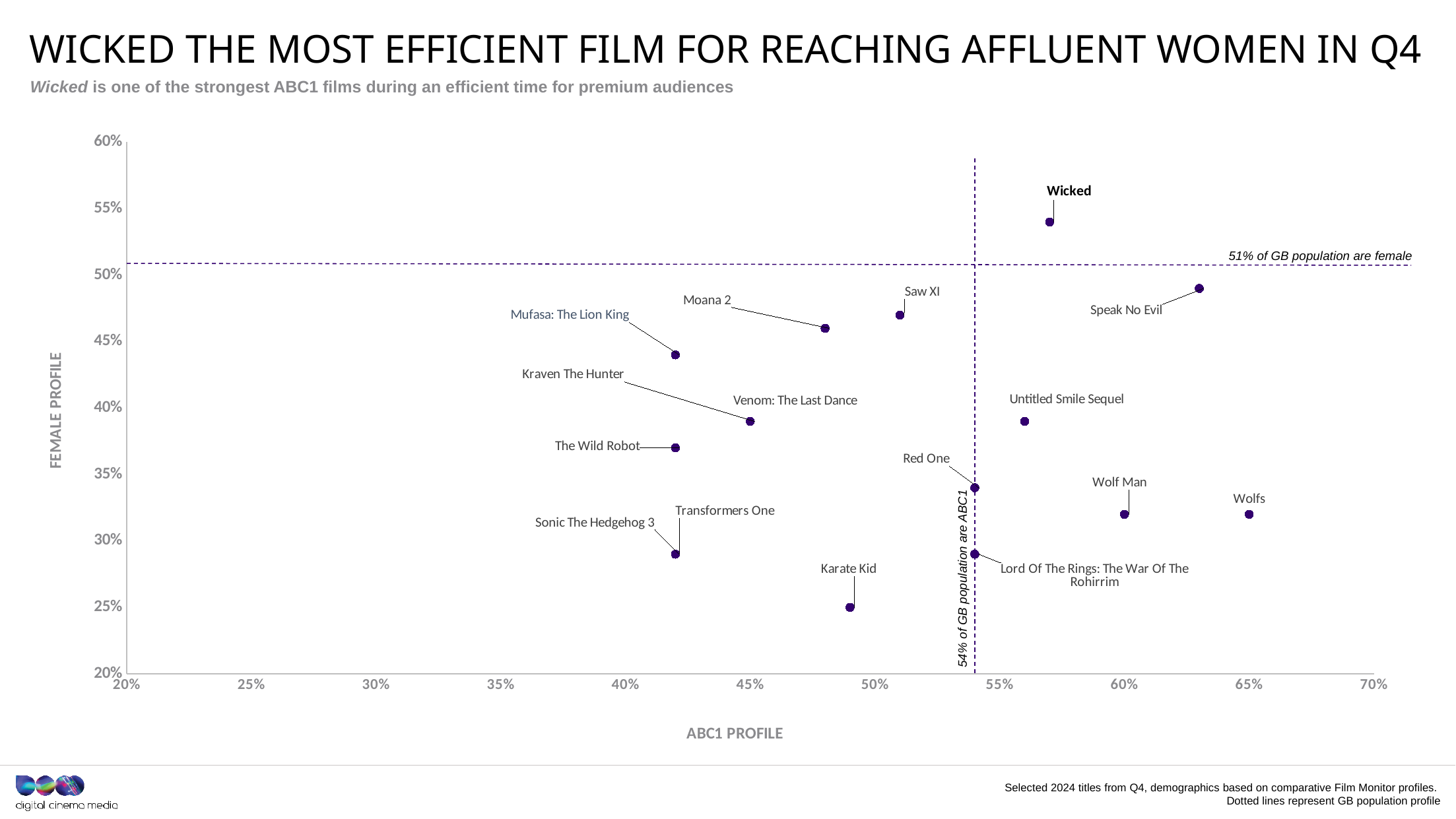
Is the ABC1 profile for Karate Kid greater or less than 50%? less Which film has the highest female profile? Wicked Is the female profile for Speak No Evil greater or less than 50%? less What is the title of the x axis? ABC1 PROFILE Which has a higher ABC1 profile, Wolf Man or The Wild Robot? Wolf Man Which film has the highest ABC1 profile? Wolfs Is the female profile for Wicked greater or less than 50%? greater According to the horizontal dotted line, what percentage of the GB population are female? 51% Which film has the lowest female profile? Karate Kid Which has a higher female profile, Moana 2 or Venom: The Last Dance? Moana 2 What kind of chart is shown on the slide? Scatter chart